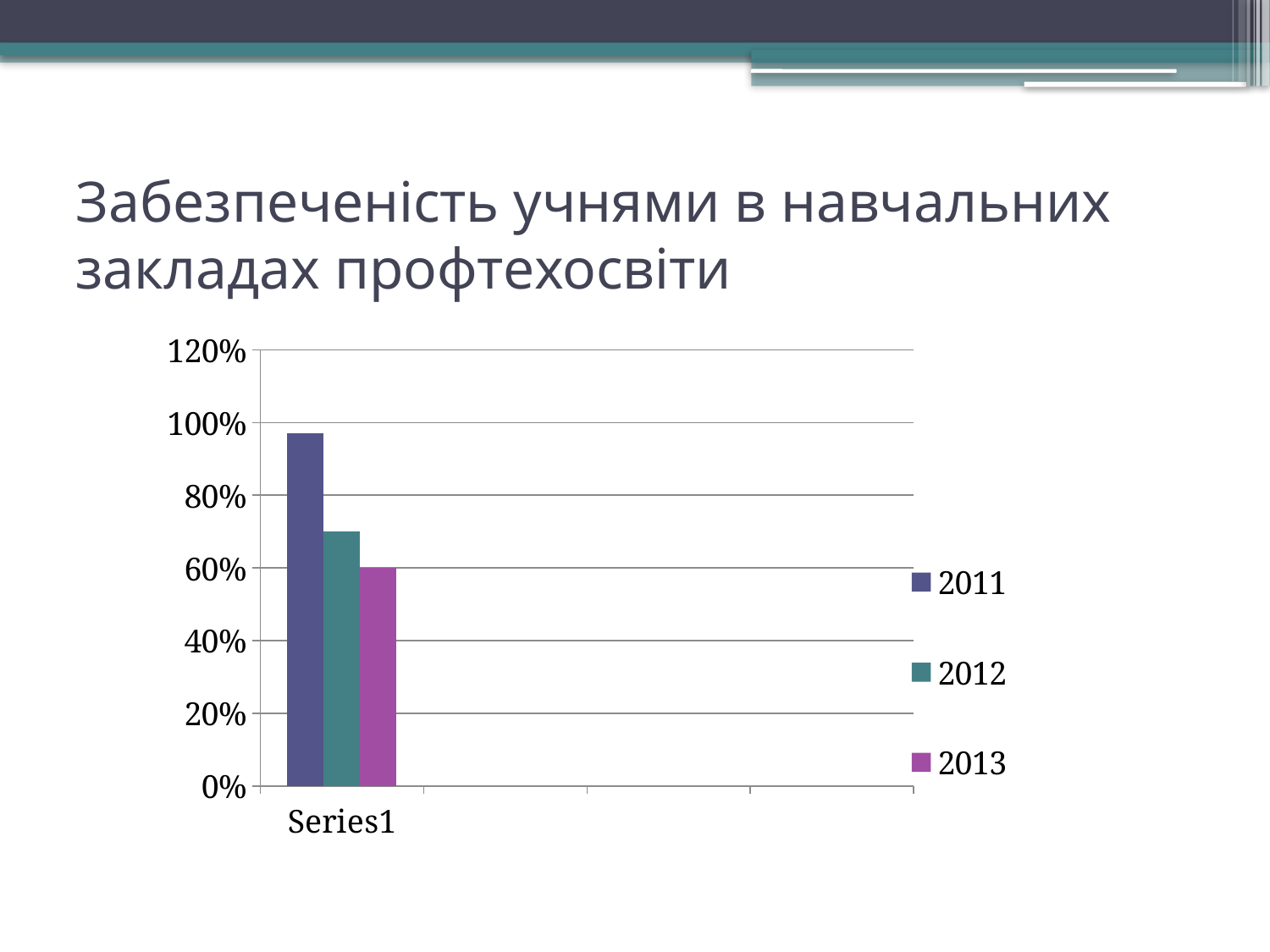
Which is larger, the value for 2011 or the value for 2012? 2011 Which year has the highest bar? 2011 Which year has the lowest bar? 2013 Do the values rise or fall from 2011 to 2013? fall How many series does the legend list? 3 What is the title of the slide? Забезпеченість учнями в навчальних закладах профтехосвіти Is the value for 2012 greater or less than 80%? less How many categories are shown on the x axis? 1 What is the value for 2013? 60% Is the value for 2011 greater or less than 100%? less What kind of chart is shown on the slide? bar chart Is the value for 2011 greater or less than 80%? greater